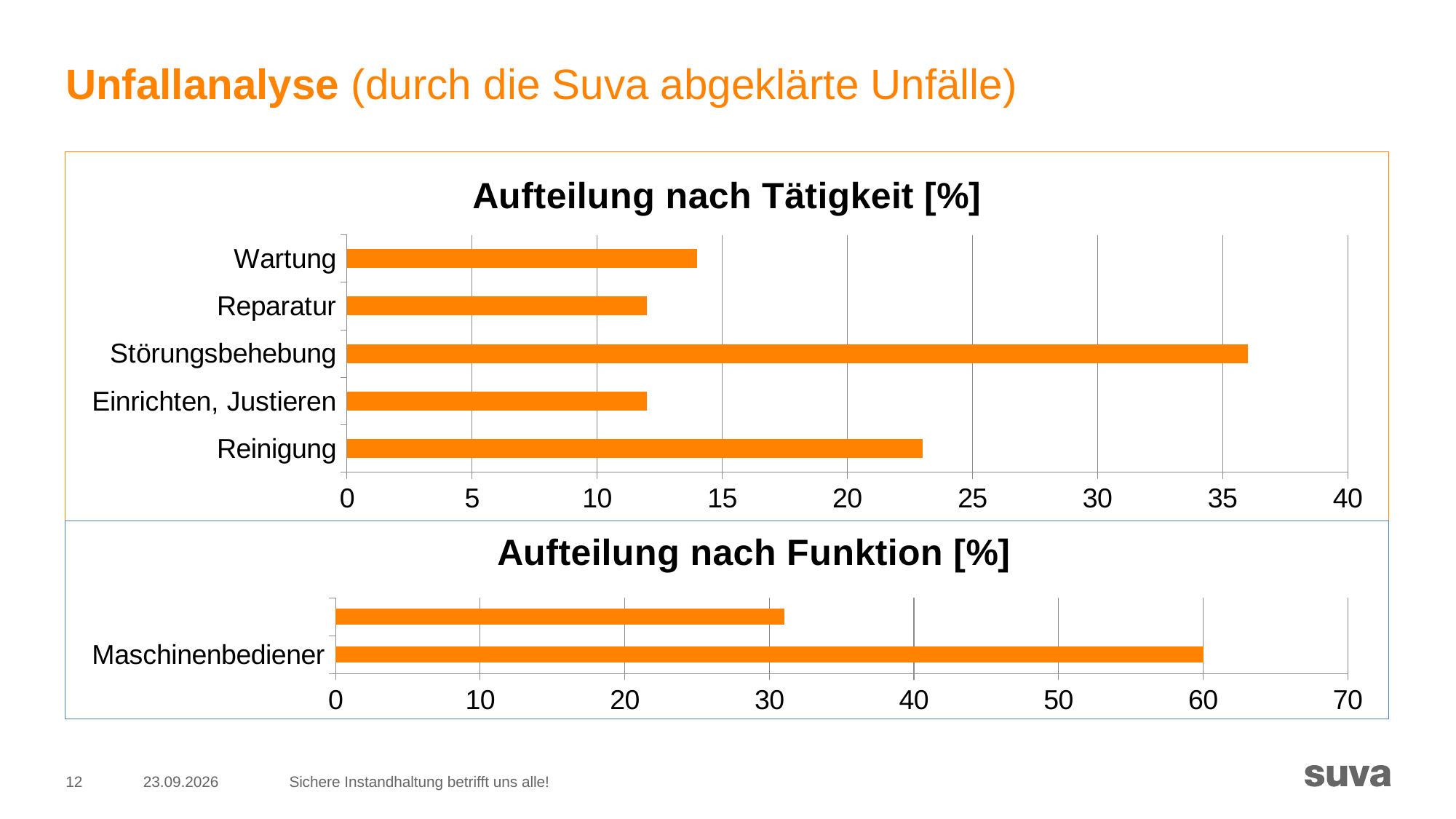
How many categories are shown in the 'Aufteilung nach Tätigkeit [%]' chart? 5 In the 'Aufteilung nach Tätigkeit [%]' chart, which category has the highest value? Störungsbehebung In the 'Aufteilung nach Tätigkeit [%]' chart, which is larger, Reinigung or Wartung? Reinigung What is the title of the top chart on the slide? Aufteilung nach Tätigkeit [%] In the 'Aufteilung nach Tätigkeit [%]' chart, is the value for Reparatur greater or less than 10? greater What is the title of the bottom chart on the slide? Aufteilung nach Funktion [%] In the 'Aufteilung nach Tätigkeit [%]' chart, is the value for Störungsbehebung greater or less than 35? greater In the 'Aufteilung nach Tätigkeit [%]' chart, which is larger, Störungsbehebung or Reinigung? Störungsbehebung In the 'Aufteilung nach Funktion [%]' chart, is the value for Maschinenbediener greater or less than 50? greater What kind of chart is the 'Aufteilung nach Tätigkeit [%]' chart? bar chart